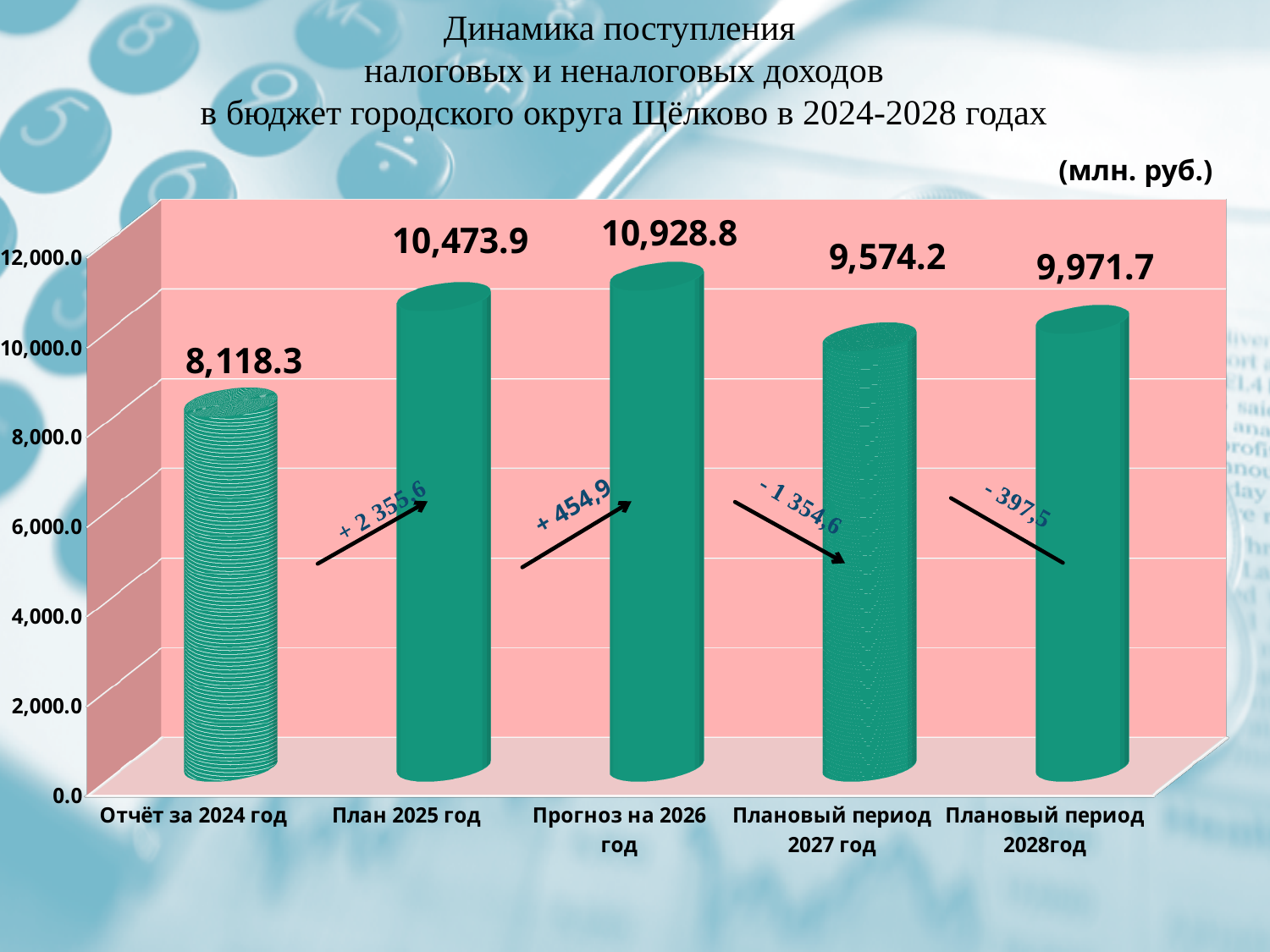
What is the value for «Отчёт за 2024 год»? 8,118.3 What is the value for «Прогноз на 2026 год»? 10,928.8 Which category has the lowest value? Отчёт за 2024 год Which category has the highest value? Прогноз на 2026 год What is the difference between the values for «План 2025 год» and «Отчёт за 2024 год»? 2,355.6 Is the value for «Отчёт за 2024 год» greater or less than 10,000.0? less What is the difference between the values for «Прогноз на 2026 год» and «Плановый период 2027 год»? 1,354.6 What is the value for «План 2025 год»? 10,473.9 What is the value for «Плановый период 2028год»? 9,971.7 How many categories are shown on the chart? 5 What kind of chart is shown on the slide? bar chart Which is larger: the value for «Плановый период 2027 год» or «Плановый период 2028год»? Плановый период 2028год